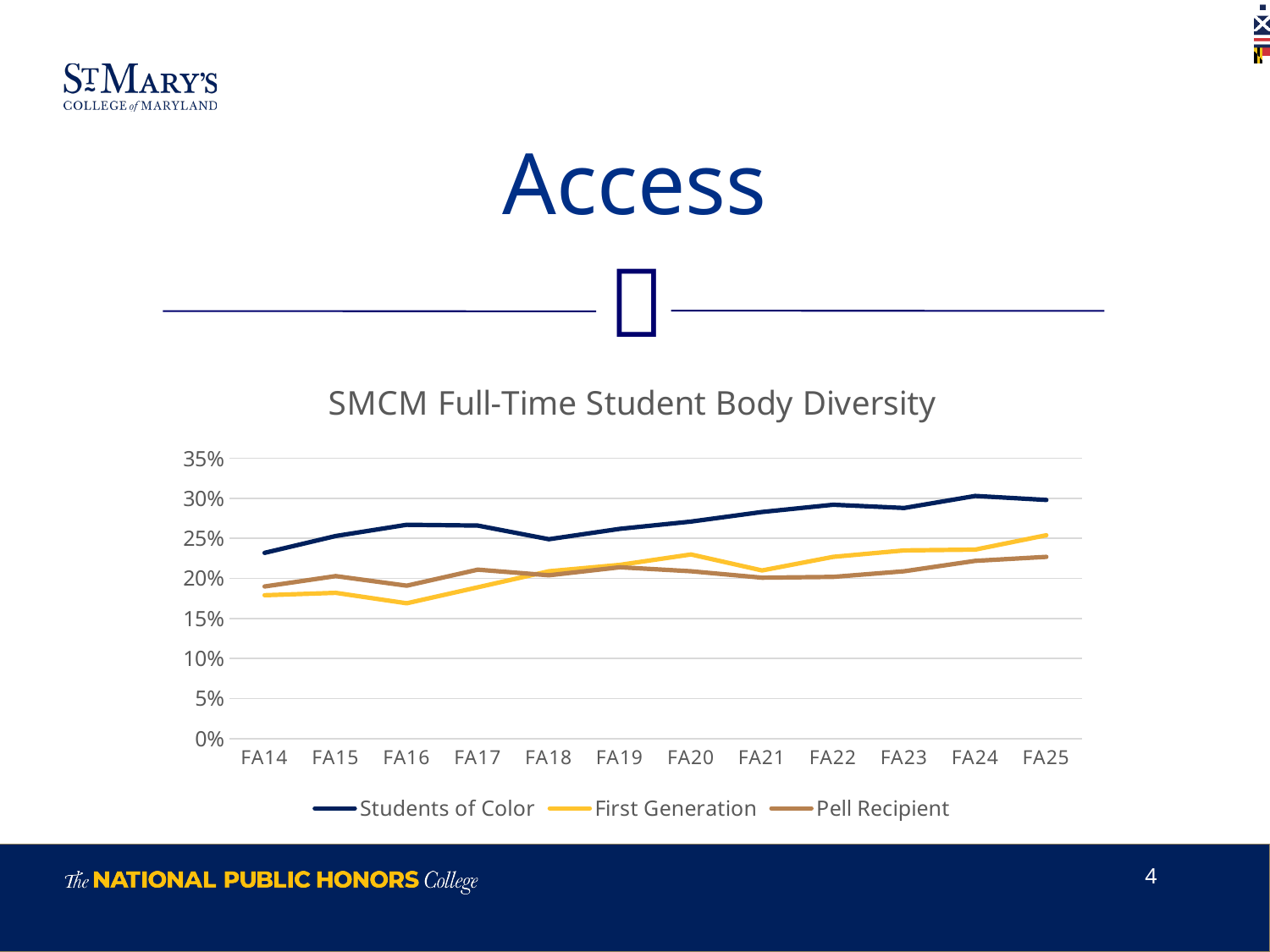
Which series has the highest value in FA25? Students of Color In which year is the First Generation series at its lowest? FA16 What is the title of the chart? SMCM Full-Time Student Body Diversity Does the Students of Color series generally rise or fall from FA14 to FA25? rise How many series does the legend list? 3 Is the value for First Generation in FA16 greater or less than 20%? less Is the value for Pell Recipient in FA25 greater or less than 25%? less Which series has the lowest value in FA16? First Generation How many years are shown along the x axis? 12 In FA25, which is larger: First Generation or Pell Recipient? First Generation Is the value for Students of Color in FA24 greater or less than 25%? greater What kind of chart is shown on the slide? Line chart